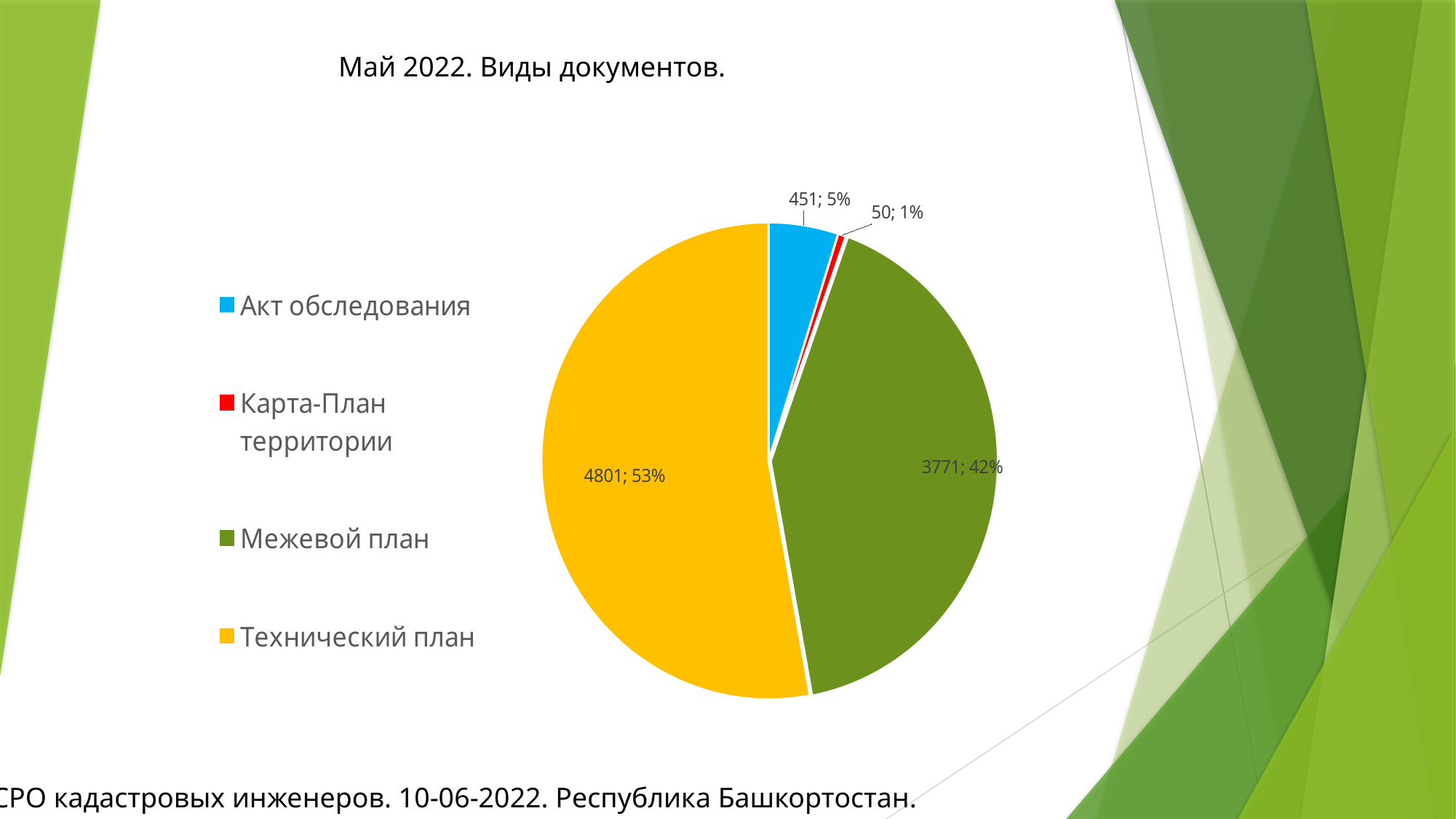
What is the value for Карта-План территории? 50 Which category has the smallest slice? Карта-План территории What is the value for Межевой план? 3771 What is the value for Технический план? 4801 Which is larger, Акт обследования or Карта-План территории? Акт обследования What is the difference between the values for Технический план and Межевой план? 1030 Which category has the largest slice? Технический план What kind of chart is shown on the slide? pie chart What is the title of the chart? Май 2022. Виды документов. How many slices does the pie chart have? 4 What is the value for Акт обследования? 451 What share of the pie does Межевой план represent? 42%